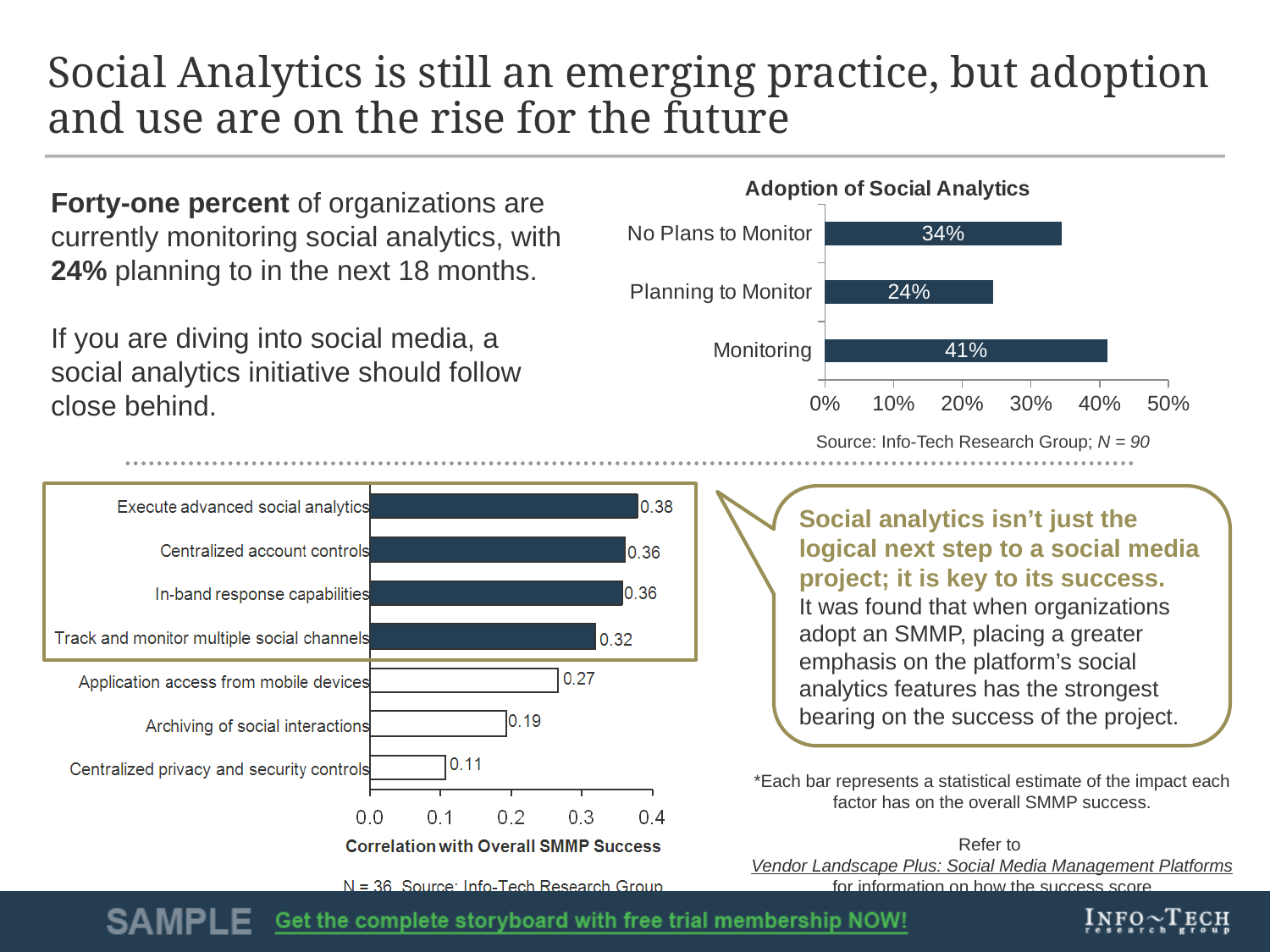
In the 'Adoption of Social Analytics' chart, which category has the lowest value? Planning to Monitor In the bottom-left chart (Correlation with Overall SMMP Success), what is the value for Centralized privacy and security controls? 0.11 In the bottom-left chart (Correlation with Overall SMMP Success), what is the value for Execute advanced social analytics? 0.38 In the 'Adoption of Social Analytics' chart, what percentage of organizations are Monitoring? 41% What type of chart is the 'Adoption of Social Analytics' chart? Bar chart In the 'Adoption of Social Analytics' chart, what is the value for Planning to Monitor? 24% In the bottom-left chart (Correlation with Overall SMMP Success), which factor has the lowest correlation? Centralized privacy and security controls In the 'Adoption of Social Analytics' chart, how many categories are shown? 3 In the 'Adoption of Social Analytics' chart, what is the difference between Monitoring and No Plans to Monitor? 7% In the bottom-left chart (Correlation with Overall SMMP Success), how many factors are plotted? 7 In the bottom-left chart (Correlation with Overall SMMP Success), which is larger: Application access from mobile devices or Archiving of social interactions? Application access from mobile devices In the 'Adoption of Social Analytics' chart, which category has the highest value? Monitoring